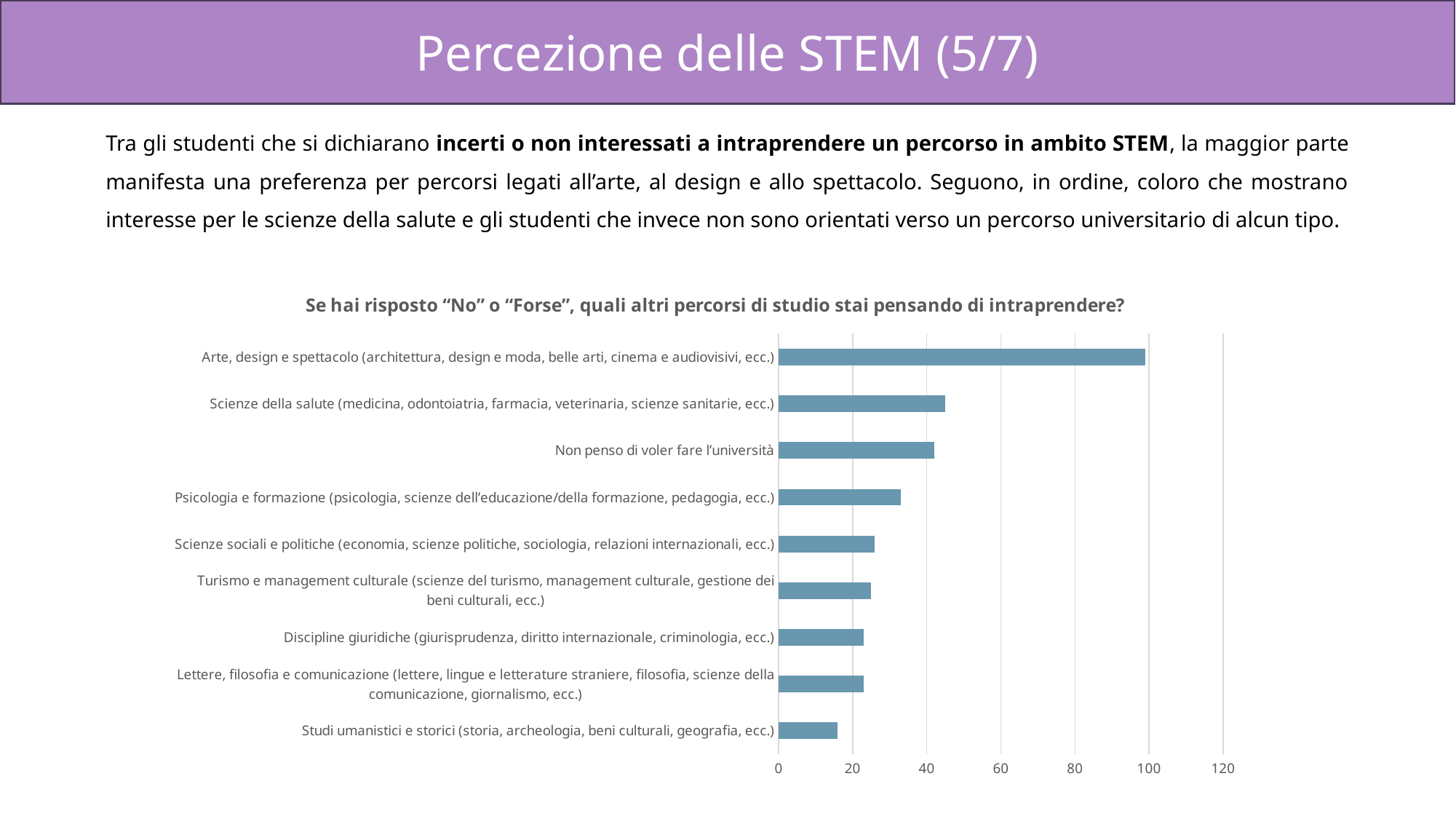
Is the value for Arte, design e spettacolo greater or less than 80? greater What is the title of the chart? Se hai risposto “No” o “Forse”, quali altri percorsi di studio stai pensando di intraprendere? Which category has the lowest value in the chart? Studi umanistici e storici Is the value for Scienze della salute greater or less than 60? less Which category has the highest value in the chart? Arte, design e spettacolo Which is larger: the value for Psicologia e formazione or the value for Scienze sociali e politiche? Psicologia e formazione Which is larger: the value for Arte, design e spettacolo or the value for Scienze della salute? Arte, design e spettacolo Is the value for Psicologia e formazione greater or less than 40? less How many categories (study paths) are shown in the chart? 9 What kind of chart is shown on the slide? Bar chart